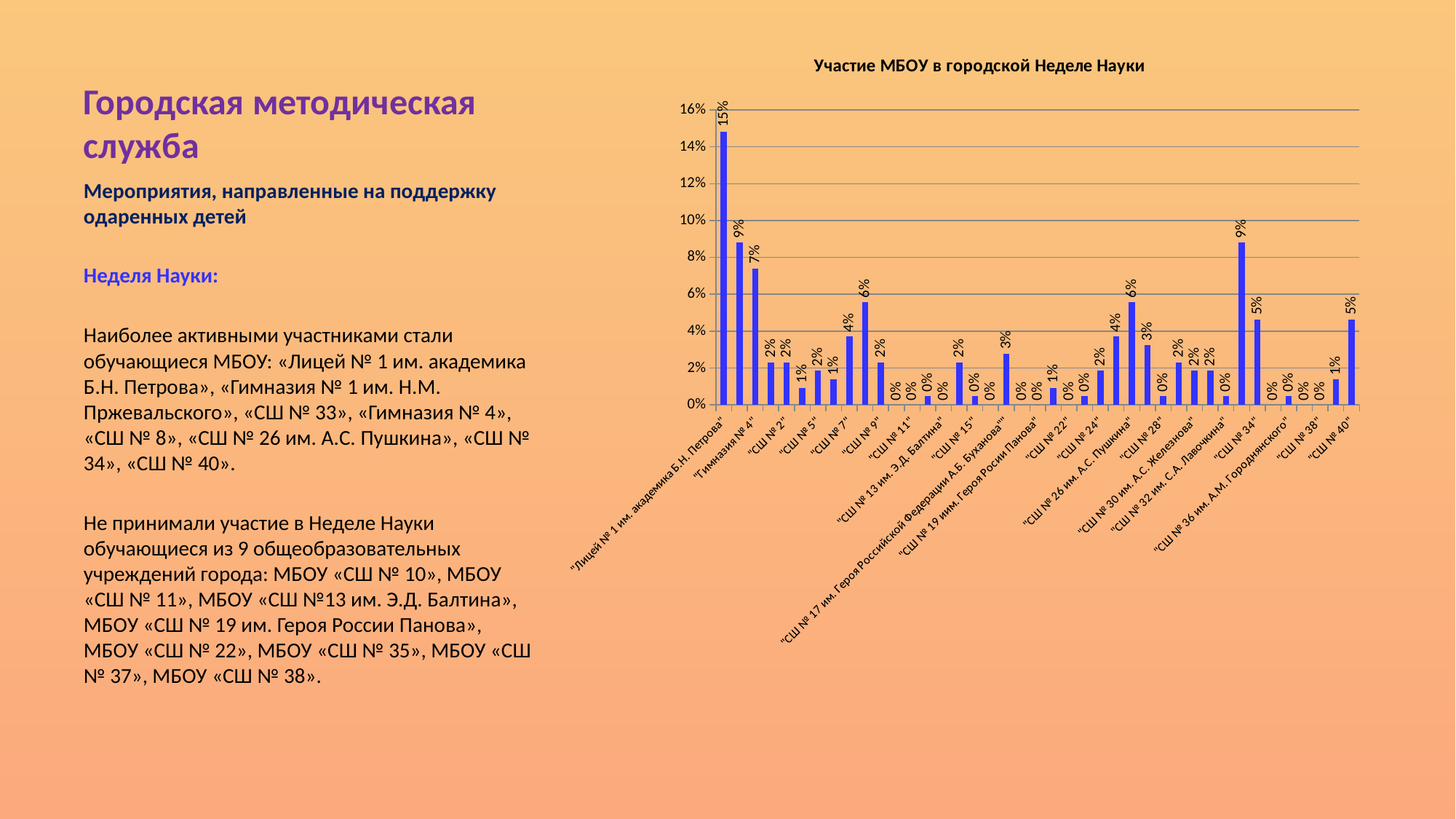
What is the value for "Лицей № 1 им. академика Б.Н. Петрова" in the chart? 15% What is the value for "СШ № 17 им. Героя Российской Федерации А.Б. Буханова" in the chart? 3% What is the title of the chart? Участие МБОУ в городской Неделе Науки What is the difference between the values for "Лицей № 1 им. академика Б.Н. Петрова" and "Гимназия № 4"? 8% What is the value for "Гимназия № 4" in the chart? 7% Which category has the highest value in the chart? "Лицей № 1 им. академика Б.Н. Петрова" What is the value for "СШ № 26 им. А.С. Пушкина" in the chart? 6% Is the value for "Лицей № 1 им. академика Б.Н. Петрова" greater or less than 14%? greater Which is larger, the value for "СШ № 26 им. А.С. Пушкина" or the value for "СШ № 34"? "СШ № 26 им. А.С. Пушкина" What is the value for "СШ № 7" in the chart? 4% What is the value for "СШ № 34" in the chart? 5% What kind of chart is shown on the slide? Bar chart